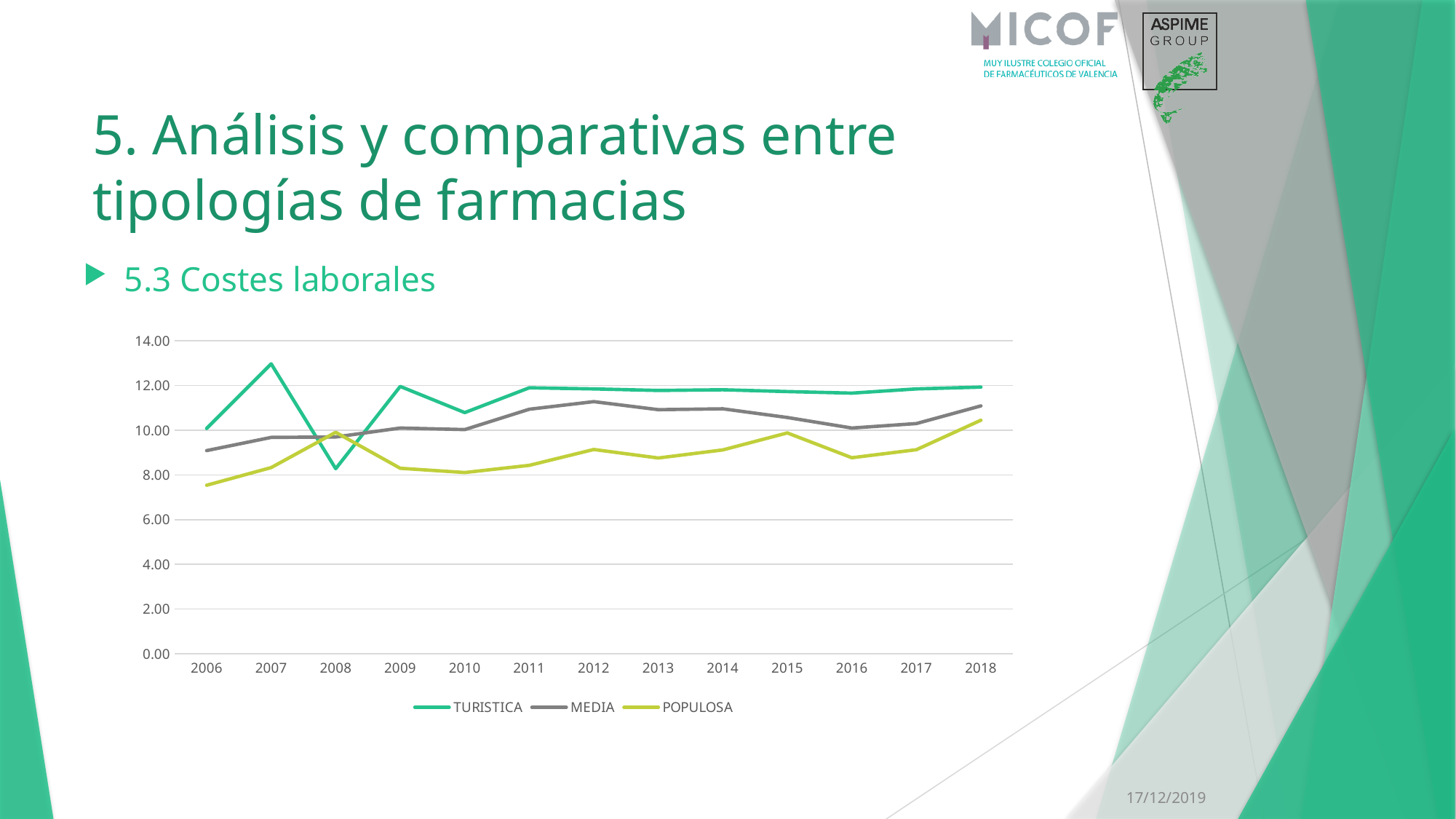
Is the value for POPULOSA in 2006 greater or less than 8.00? less How many years are shown on the x axis? 13 In which year does the TURISTICA series reach its lowest value? 2008 How many series does the legend list? 3 Is the value for TURISTICA in 2007 greater or less than 12.00? greater In 2008, which series has the larger value, MEDIA or TURISTICA? MEDIA In 2018, which series has the larger value, POPULOSA or MEDIA? MEDIA In which year does the TURISTICA series reach its highest value? 2007 Is the value for MEDIA in 2012 greater or less than 10.00? greater Does the POPULOSA series rise or fall from 2016 to 2018? rise What kind of chart is shown on the slide? line chart In which year does the POPULOSA series have its lowest value? 2006